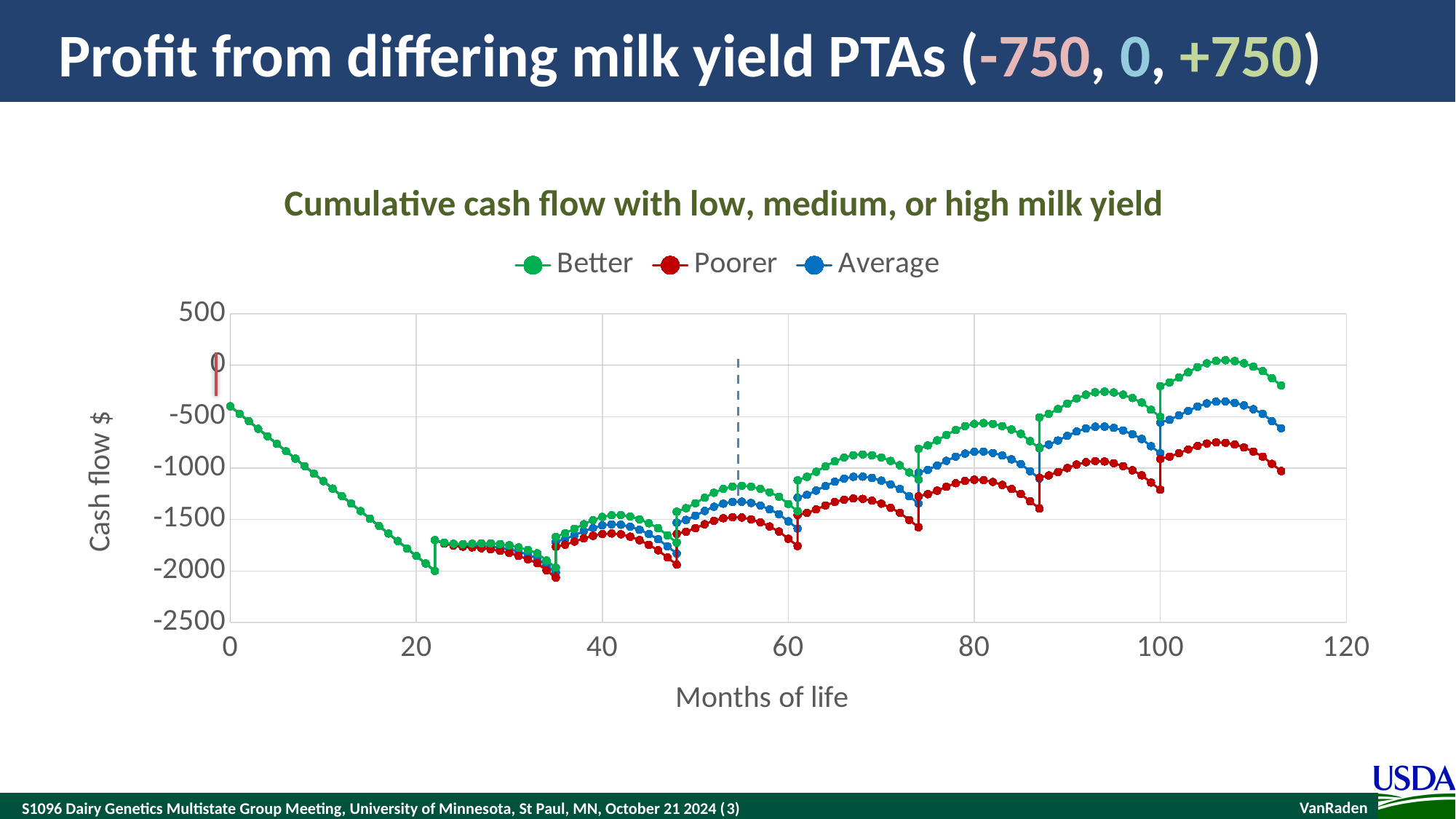
What kind of chart is shown on the slide? Line chart Which series has the highest cash flow at month 100? Better What is the title of the chart? Cumulative cash flow with low, medium, or high milk yield Does the cash flow rise or fall between month 0 and month 20? Fall At month 80, is the cash flow for the Better series higher or lower than for the Poorer series? Higher Does the cash flow for the Average series generally rise or fall between month 40 and month 110? Rise Which series has the lowest cash flow at the end of the chart (around month 113)? Poorer Is the cash flow for the Better series at month 80 greater or less than -1000? greater What are the three series named in the legend? Better, Poorer, Average How many series does the legend list? 3 Is the cash flow for the Poorer series at month 80 greater or less than -1000? less